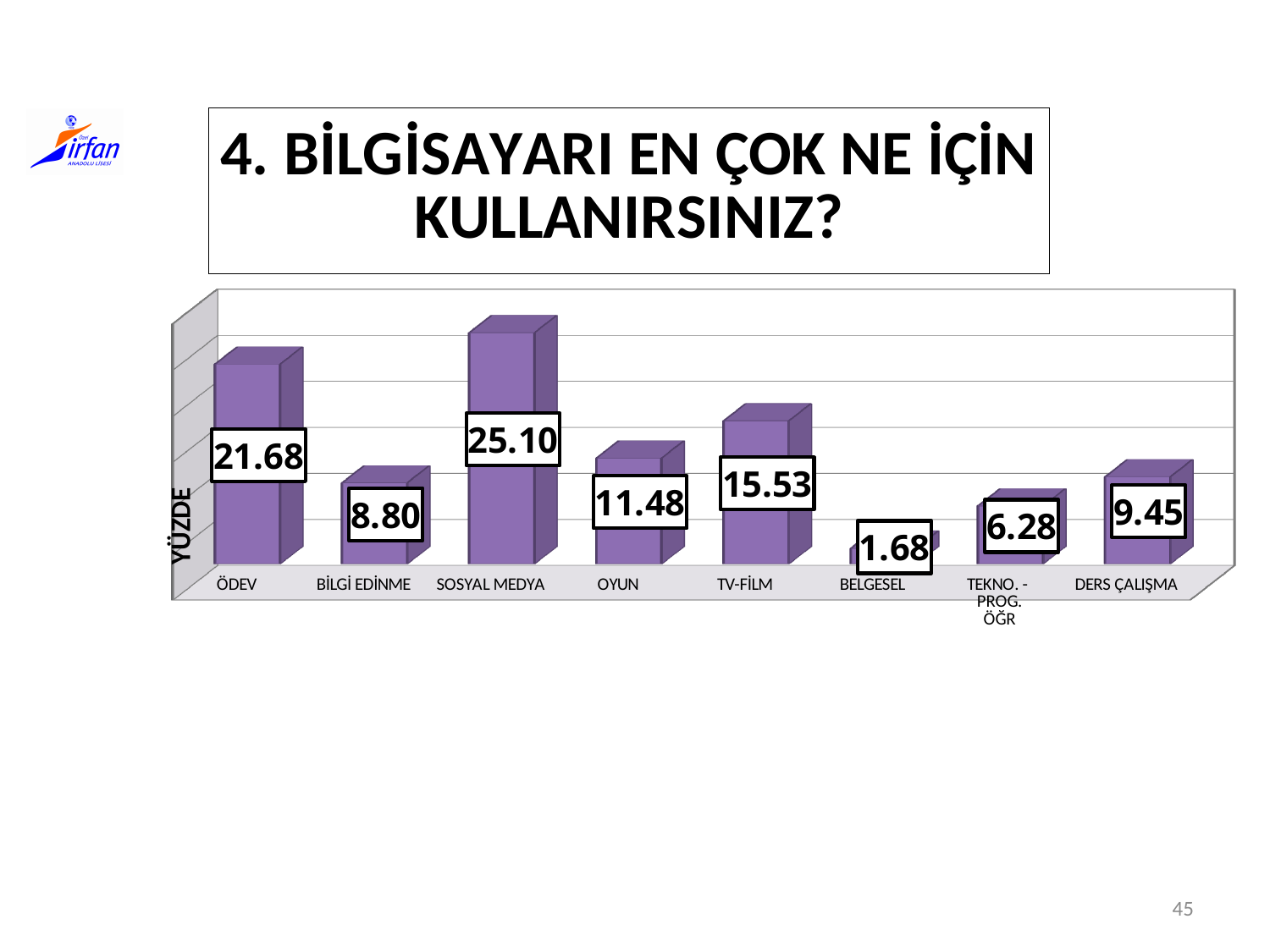
How many categories are shown on the x axis? 8 What is the value for ÖDEV? 21.68 What is the difference between the values for TV-FİLM and OYUN? 4.05 Which is larger, the value for DERS ÇALIŞMA or the value for BİLGİ EDİNME? DERS ÇALIŞMA Which category has the highest value? SOSYAL MEDYA Which category has the lowest value? BELGESEL What is the value for TEKNO. - PROG. ÖĞR? 6.28 What is the difference between the values for SOSYAL MEDYA and ÖDEV? 3.42 What is the label on the vertical axis? YÜZDE What is the title of the chart? 4. BİLGİSAYARI EN ÇOK NE İÇİN KULLANIRSINIZ? What is the value for SOSYAL MEDYA? 25.10 What kind of chart is shown on the slide? bar chart